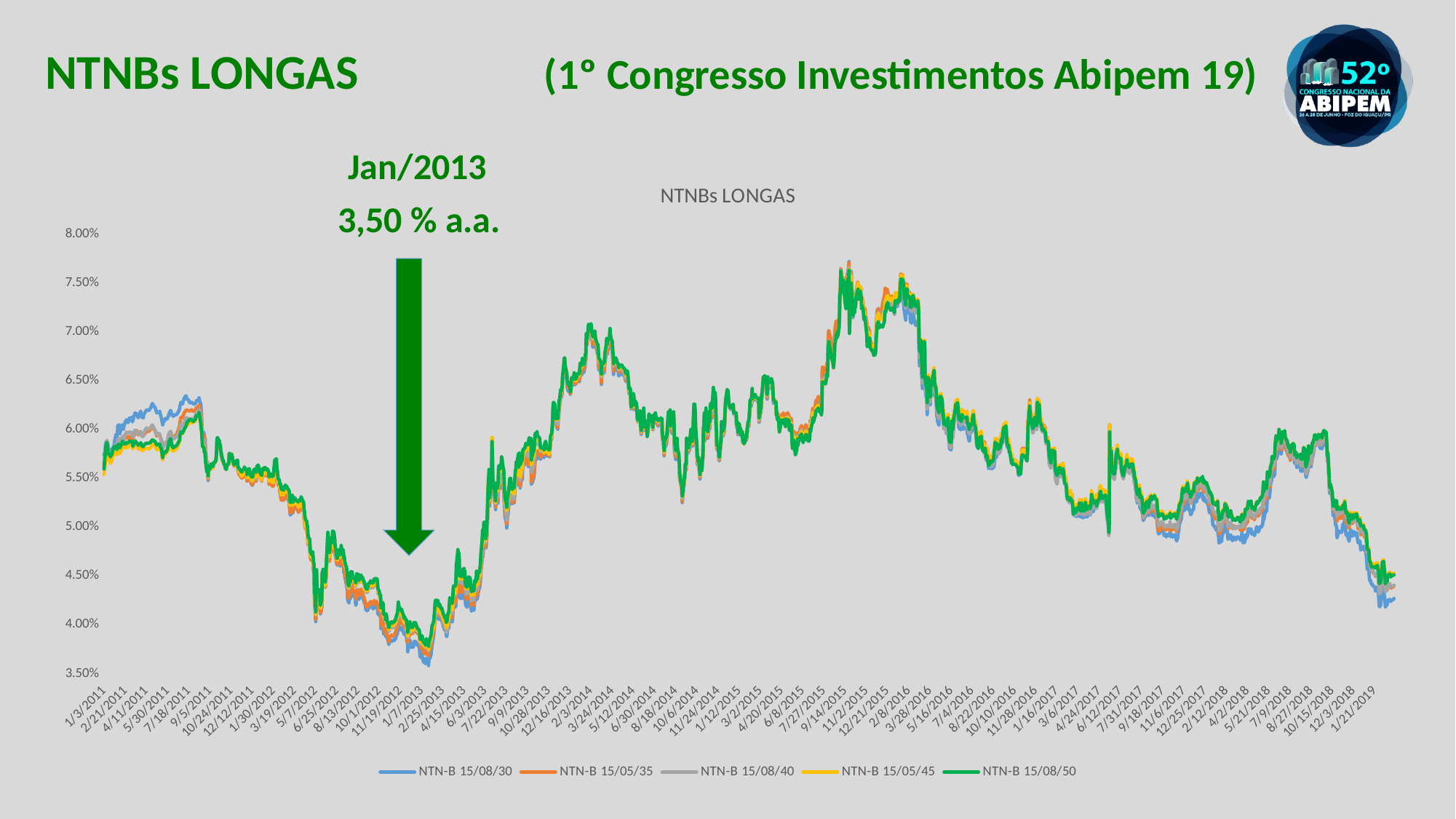
Is the value of the series around 9/14/2015 greater or less than 7.00%? greater Is the value for NTN-B 15/08/30 at 1/21/2019 greater or less than 4.50%? less At 1/21/2019, which is higher: NTN-B 15/08/50 or NTN-B 15/08/30? NTN-B 15/08/50 Is the value of the series around 2/8/2016 greater or less than 7.00%? greater Around 5/30/2011, which is higher: NTN-B 15/08/30 or NTN-B 15/08/50? NTN-B 15/08/30 Do the values rise or fall between 9/14/2015 and 1/21/2019? fall Do the values rise or fall between 1/25/2013 and 2/3/2014? rise How many series does the legend of the chart list? 5 Which series is drawn in green in the chart? NTN-B 15/08/50 What kind of chart is shown on the slide? line chart What is the title printed above the chart's plot area? NTNBs LONGAS